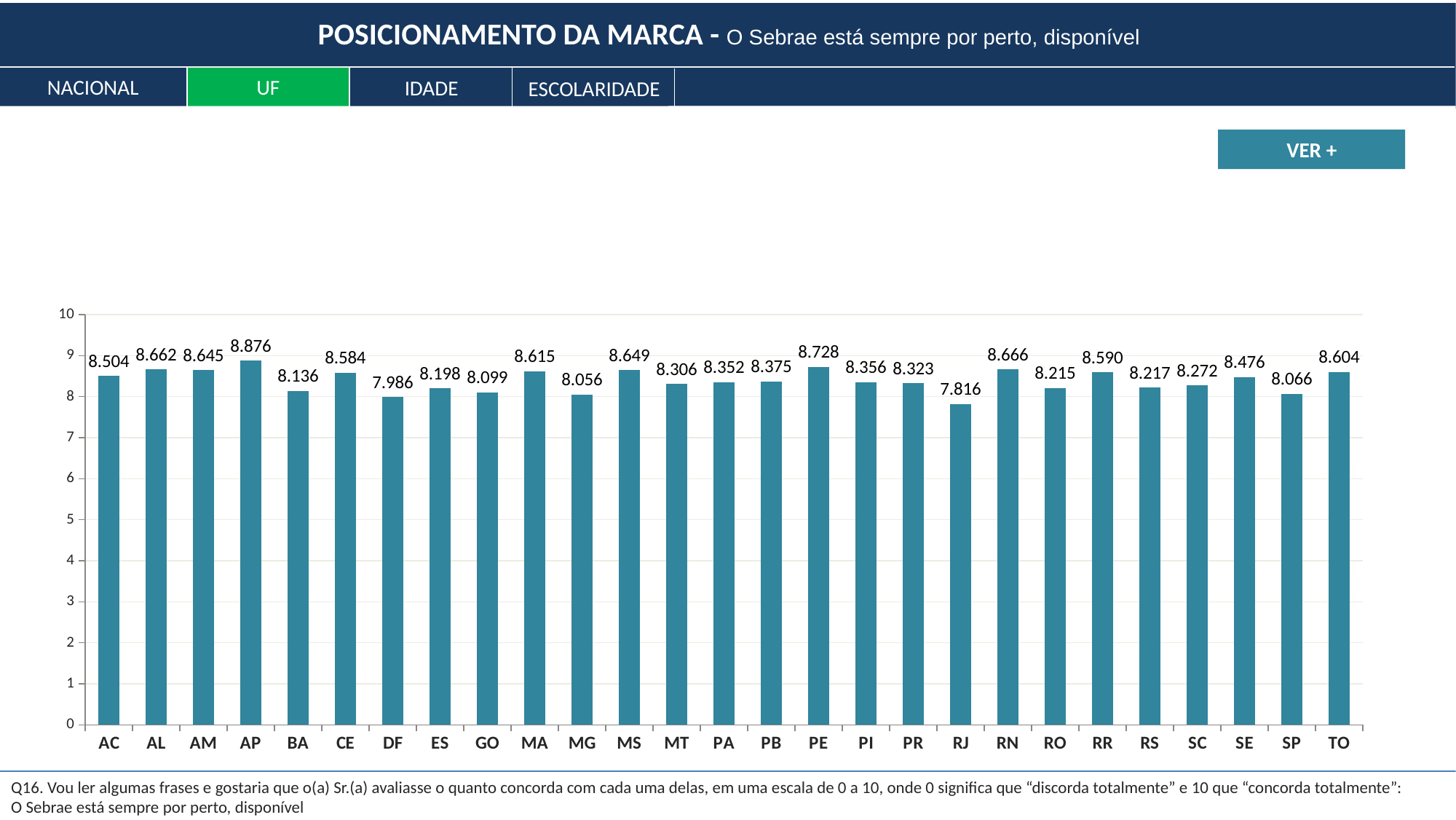
Which has a larger value, MA or MG? MA Which UF has the highest value? AP What is the difference between the values for AP and RJ? 1.060 What is the value for RJ? 7.816 What kind of chart is shown on the slide? bar chart How many UFs are shown on the x axis? 27 Which UF has the lowest value? RJ What is the value for AP? 8.876 What is the value for PE? 8.728 Is the value for DF greater or less than 8? less What is the value for SP? 8.066 What is the difference between the values for PE and DF? 0.742